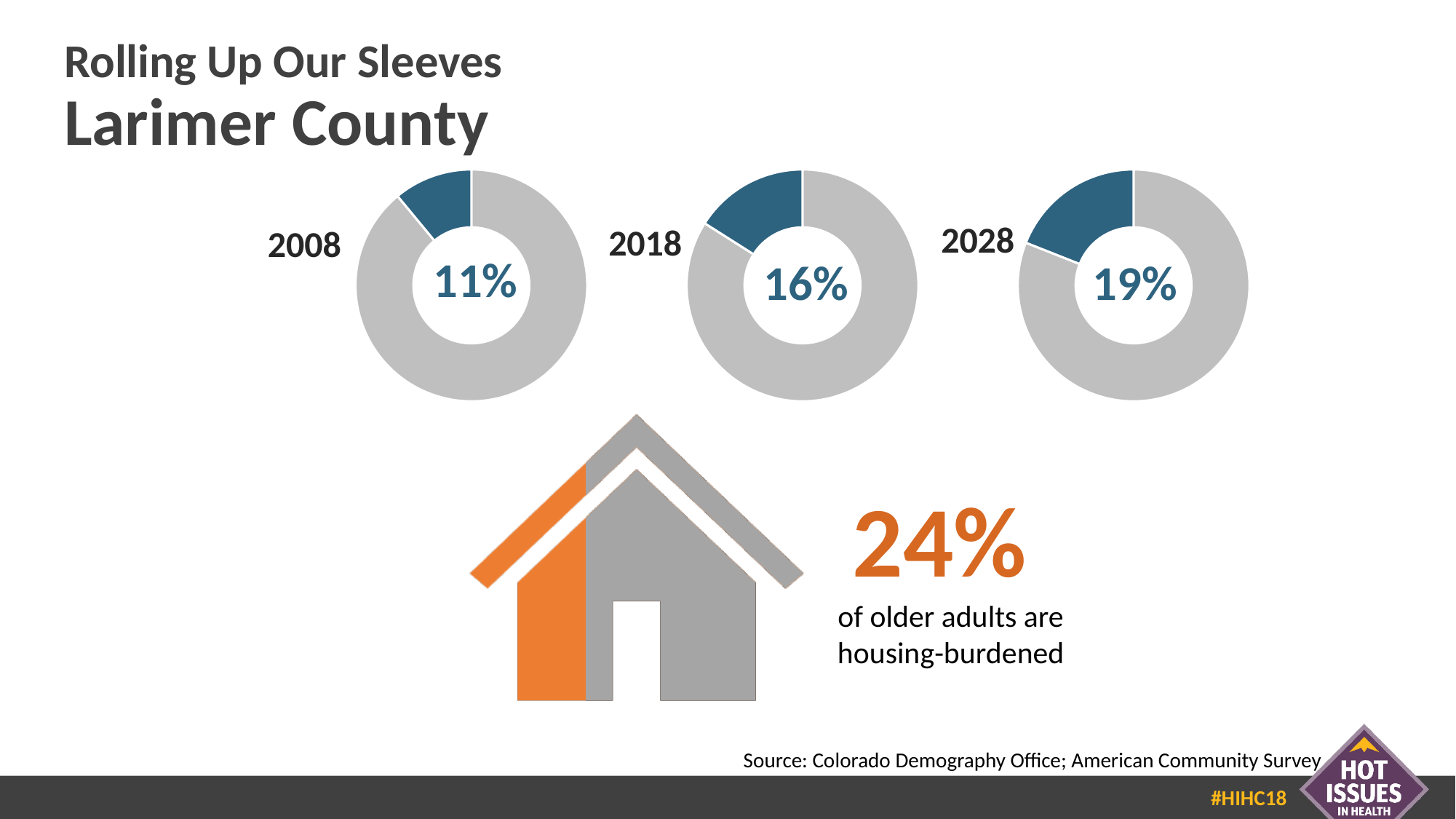
In the 2028 donut chart, what percentage is shown in the centre? 19% Which donut chart shows a larger percentage, 2018 or 2028? 2028 What kind of chart is used to show the 2008, 2018 and 2028 values? Donut chart Across the three donut charts (2008, 2018, 2028), which year shows the highest percentage? 2028 What colour is the highlighted slice in each donut chart? Dark blue In the 2008 donut chart, what percentage is shown in the centre? 11% In the 2018 donut chart, what percentage is shown in the centre? 16% What is the difference in percentage points between the 2018 donut chart and the 2008 donut chart? 5 What is the difference in percentage points between the 2028 donut chart and the 2008 donut chart? 8 Do the percentages in the donut charts rise or fall from 2008 to 2028? Rise How many donut charts are shown on the slide? 3 Across the three donut charts (2008, 2018, 2028), which year shows the lowest percentage? 2008